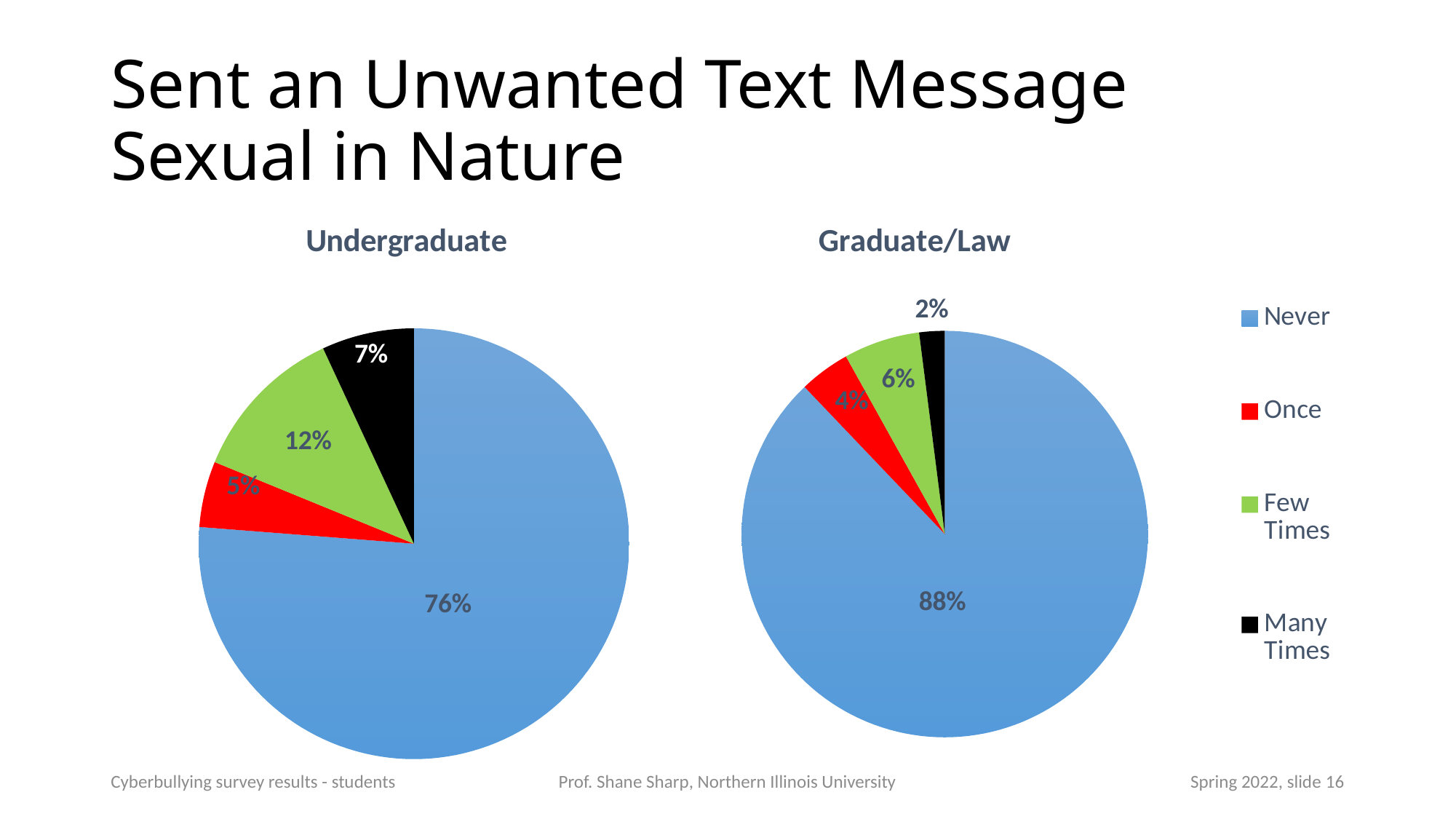
In the Graduate/Law chart, what percentage of respondents answered Never? 88% In the Graduate/Law chart, what is the share for Many Times? 2% How many categories does the legend list? 4 In the Undergraduate chart, what is the share for Few Times? 12% In the Undergraduate chart, which category has the largest slice? Never Which is larger: the Few Times share in the Undergraduate chart or the Few Times share in the Graduate/Law chart? Undergraduate In the Graduate/Law chart, which category has the smallest slice? Many Times What is the difference between the Never share in the Graduate/Law chart and the Never share in the Undergraduate chart? 12% In the Undergraduate chart, what is the share for Once? 5% In the Undergraduate chart, what percentage of respondents answered Never? 76% Which colour represents Once in the legend? Red What kind of chart is the Undergraduate chart? Pie chart